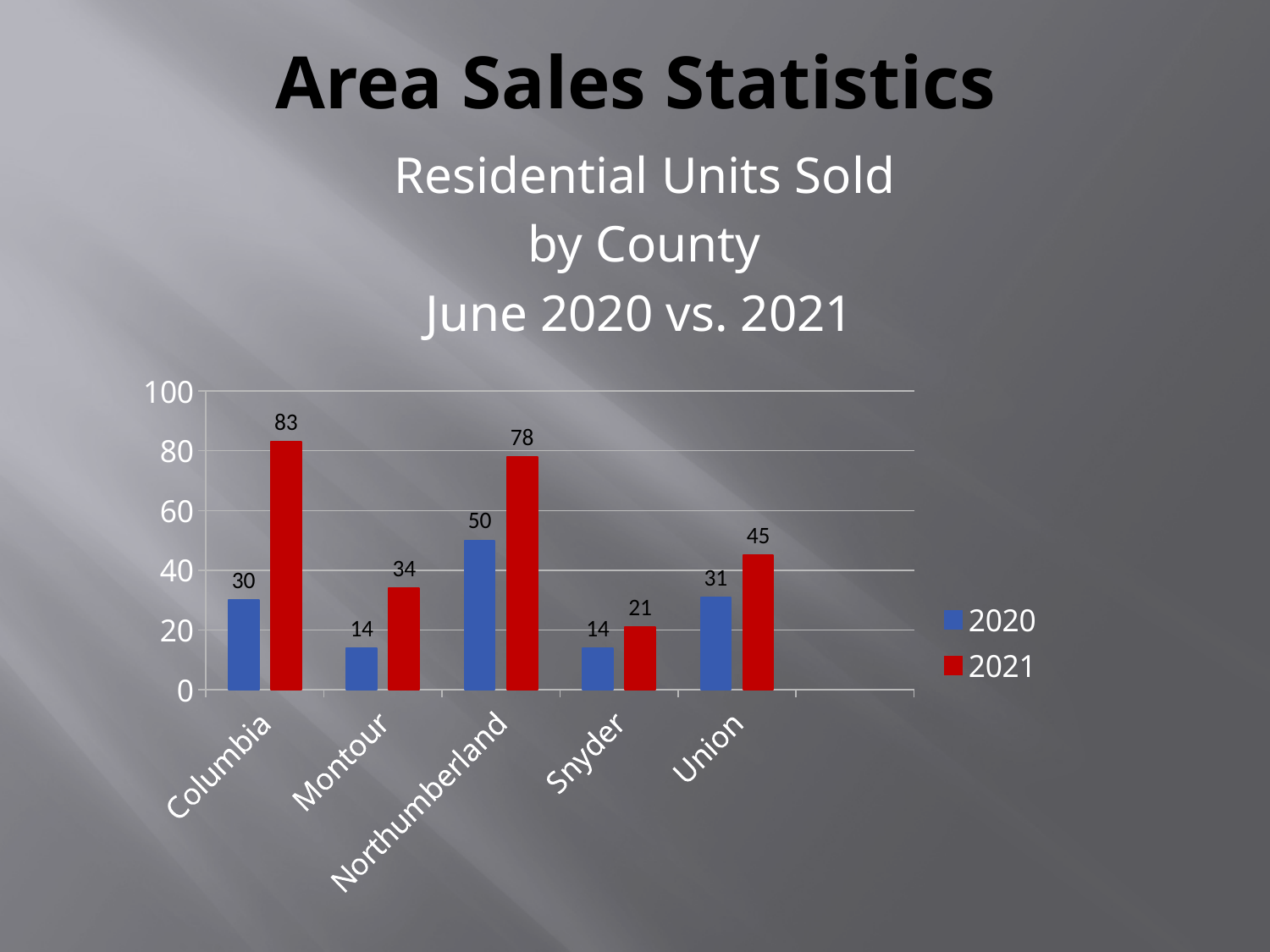
How many counties are shown on the x axis? 5 What is the difference between the 2021 values for Northumberland and Union? 33 Which county has the highest 2021 value? Columbia Which colour represents the 2021 series in the legend? Red Which is larger, the 2020 value for Union or the 2020 value for Columbia? Union What kind of chart is shown on the slide? Bar chart How many series does the legend list? 2 What is the 2020 value for Northumberland? 50 What is the 2021 value for Snyder? 21 How many residential units were sold in Columbia in 2021? 83 What is the difference between the 2021 and 2020 values for Columbia? 53 Which county has the lowest 2020 value? Montour and Snyder (tied at 14)